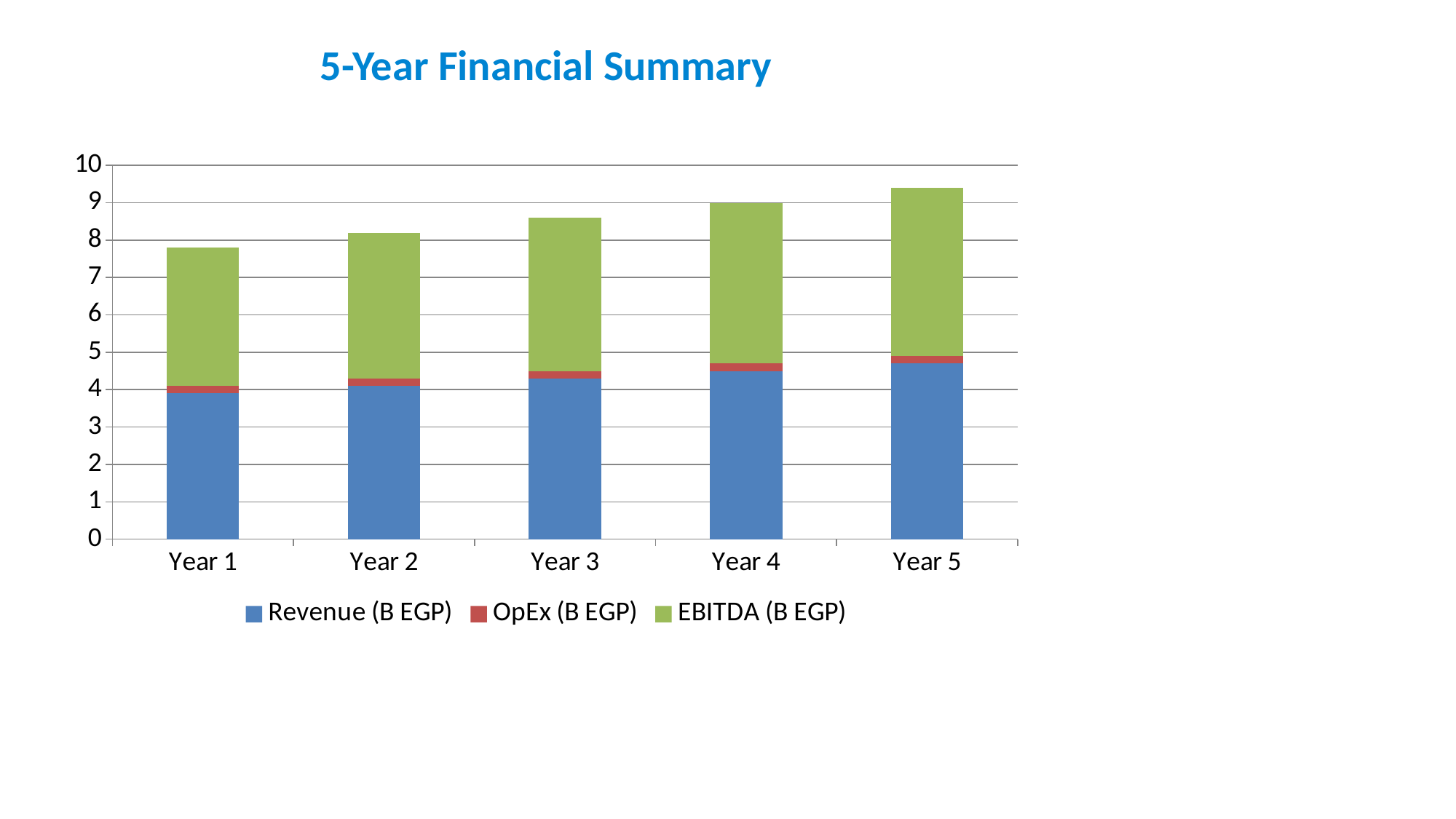
What kind of chart is shown on the slide? Stacked bar chart Is the total stacked bar for Year 3 greater or less than 8? greater Do the stacked bar totals rise or fall from Year 1 to Year 5? Rise Is the total stacked bar for Year 1 greater or less than 8? less How many years (categories) are shown on the x axis? 5 Is the total stacked bar for Year 5 greater or less than 9? greater Which year has the shortest stacked bar? Year 1 Which year has the tallest stacked bar? Year 5 How many series does the legend list? 3 Which series is shown in green in the legend? EBITDA (B EGP) Which is larger, the total stacked bar for Year 2 or for Year 4? Year 4